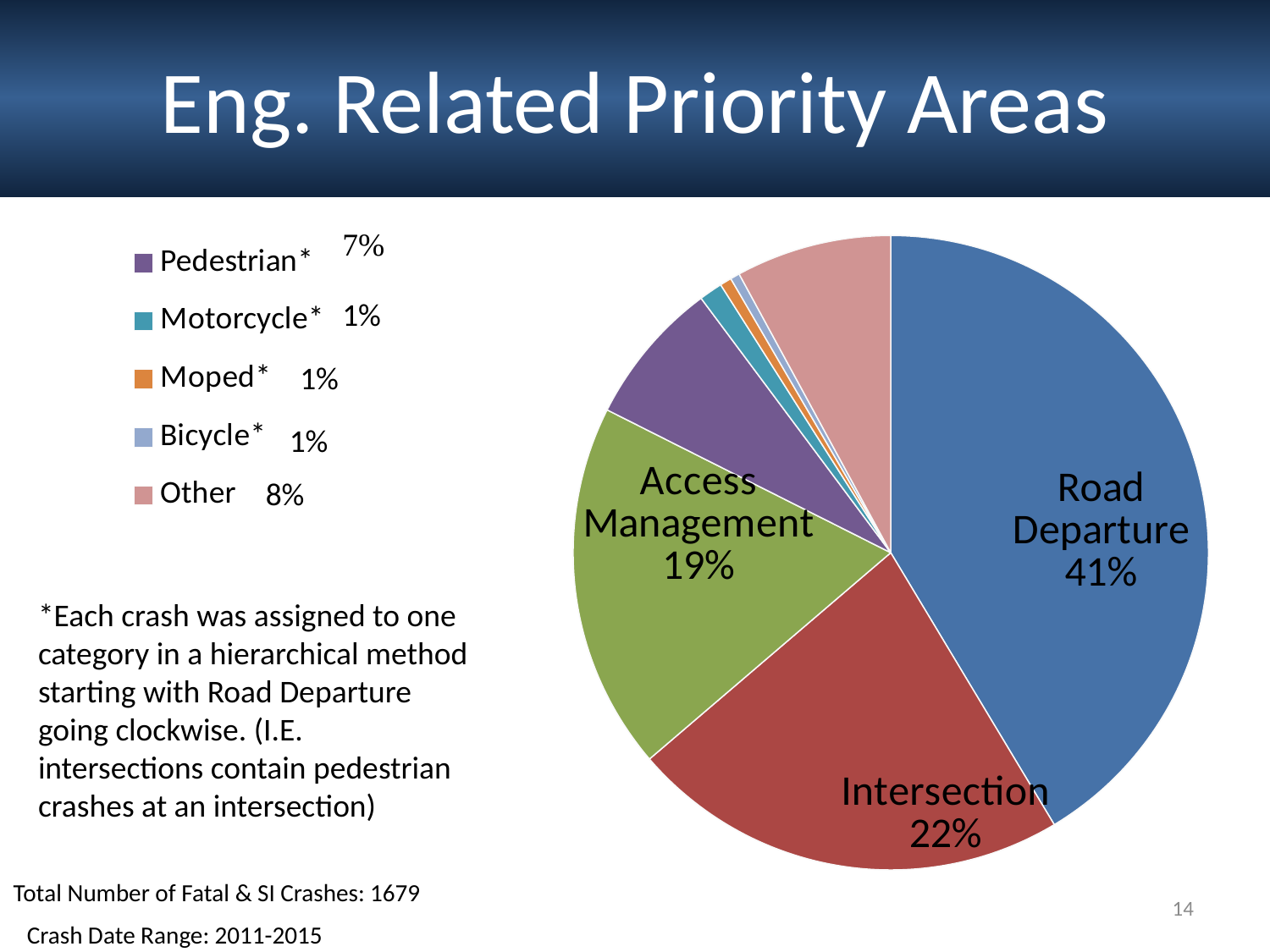
What share of the pie does Intersection represent? 22% What is the difference in percentage points between Road Departure and Intersection? 19 How many categories are shown in the pie chart? 8 What share of the pie does Road Departure represent? 41% What percentage is shown for Other? 8% What share of the pie does Access Management represent? 19% How many entries does the legend list? 5 Which category has the largest slice of the pie? Road Departure What is the title of the slide containing the chart? Eng. Related Priority Areas What kind of chart is shown on the slide? pie chart Which is larger, the Access Management slice or the Other slice? Access Management What percentage is shown for Pedestrian*? 7%